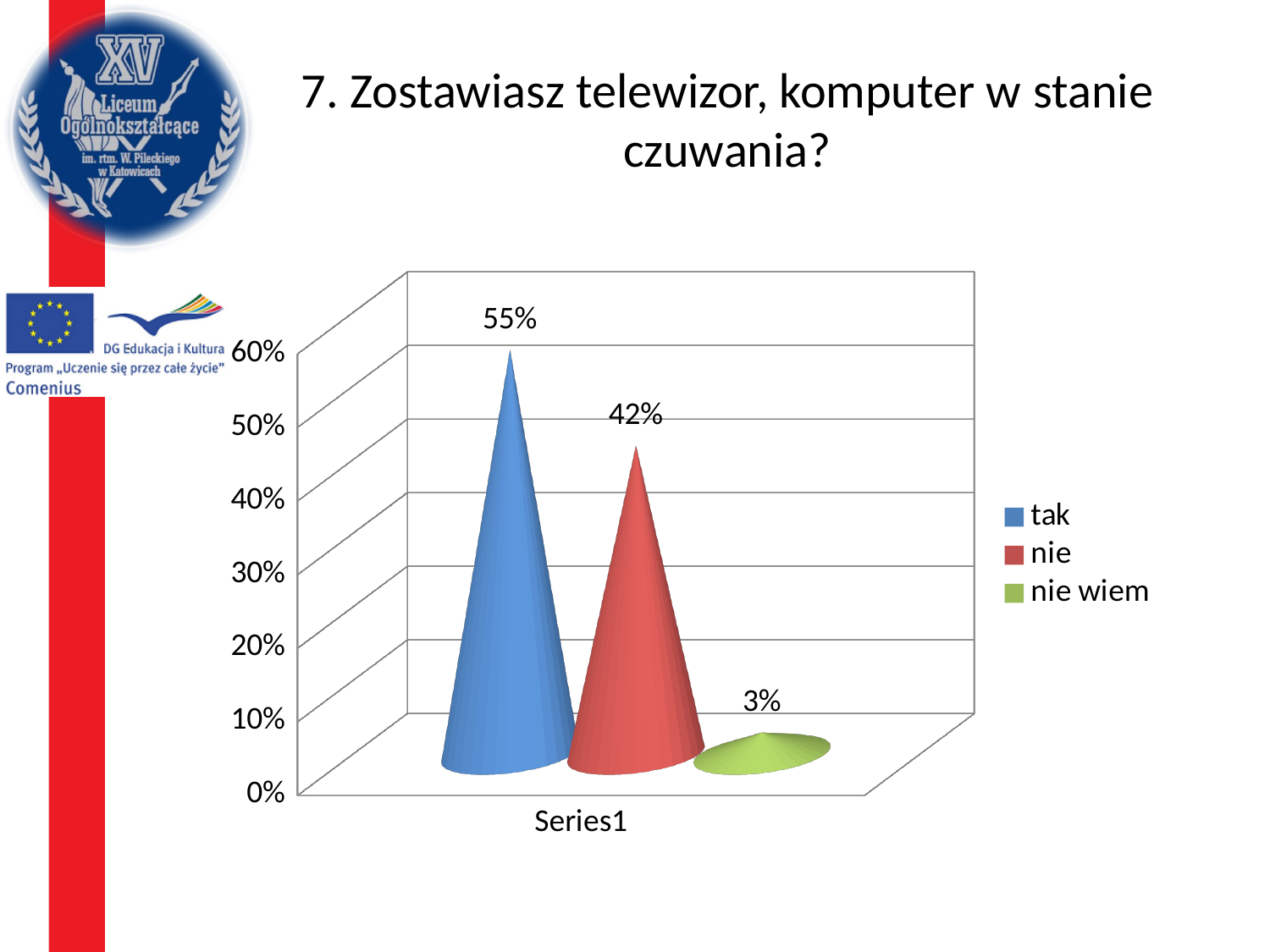
What is the value for "nie wiem"? 3% What is the difference between the values for "nie" and "nie wiem"? 39% Which answer has the lowest value? nie wiem Which answer has the highest value? tak What is the value for "nie"? 42% How many series does the legend list? 3 Is the value for "nie" greater or less than 50%? less What is the value for "tak"? 55% Which is larger, the value for "tak" or the value for "nie"? tak What is the difference between the values for "tak" and "nie"? 13% What kind of chart is shown on the slide? bar chart What colour is the bar for "nie wiem"? green